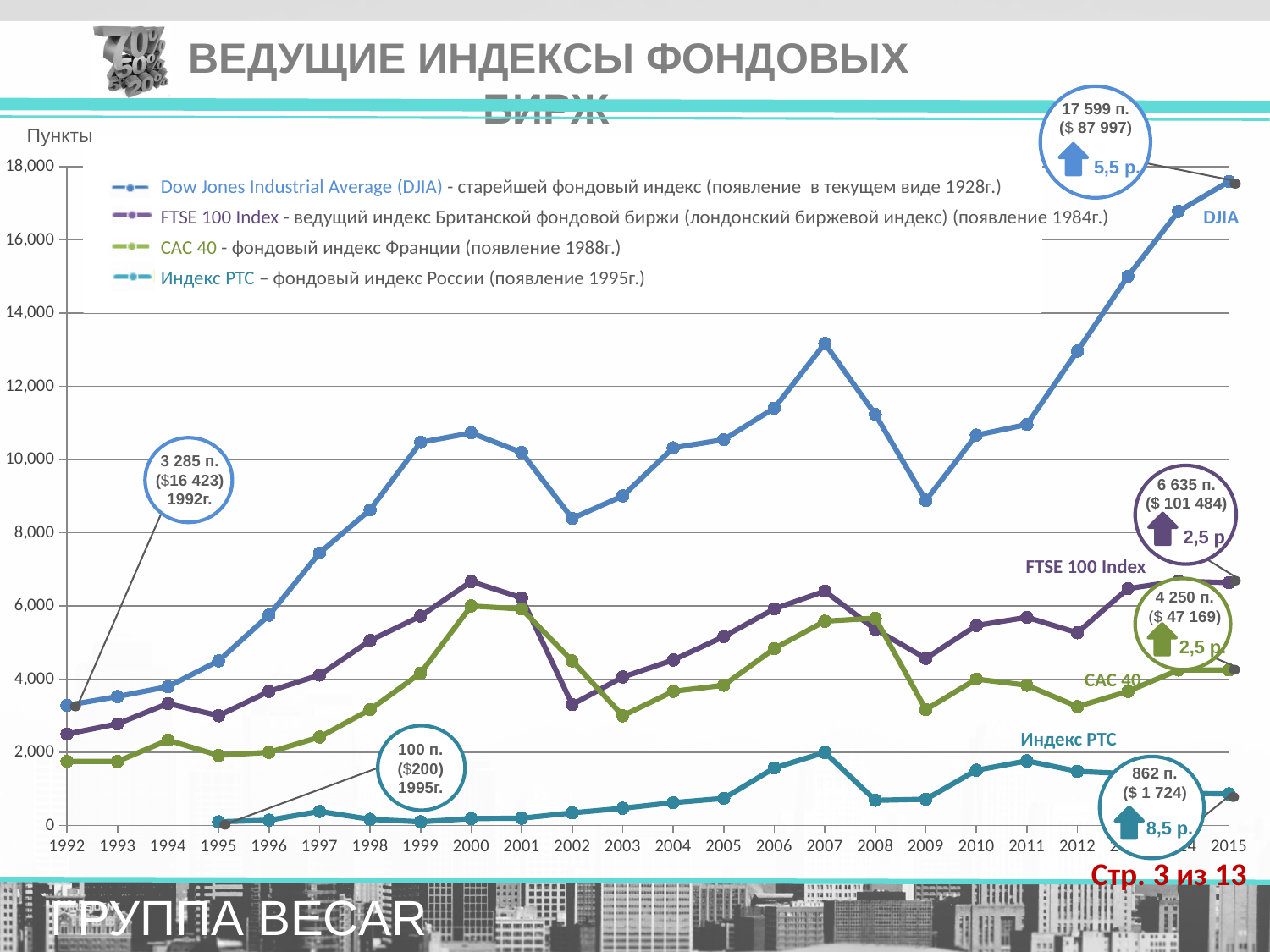
How many series does the legend list? 4 Is the CAC 40 value for 2009 greater or less than 4,000? less Which index has the lowest value in 2015? Индекс РТС What is the Индекс РТС value in points shown in the callout for 1995? 100 п. What is the FTSE 100 Index value in points shown in the callout for 2015? 6 635 п. What kind of chart is shown on the slide? line chart Which index has the highest value in 2015? DJIA Is the DJIA value for 2007 greater or less than 12,000? greater What is the DJIA value in points shown in the callout for 1992? 3 285 п. By how many points did the DJIA grow from 1992 (3 285 п.) to 2015 (17 599 п.)? 14 314 п. What is the DJIA value in points shown in the callout for 2015? 17 599 п. How many years are shown along the x axis? 24